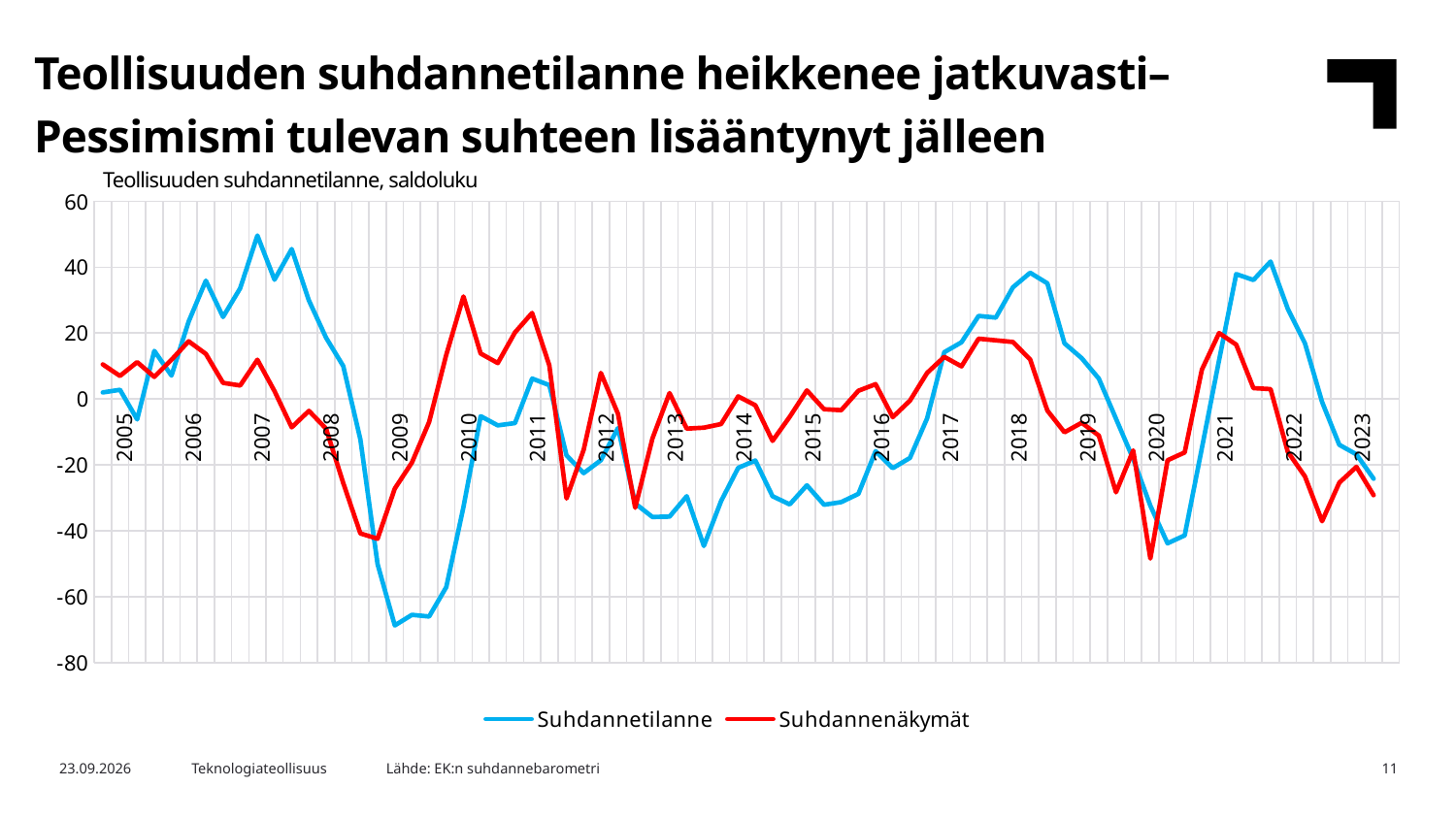
Is the peak of the Suhdannenäkymät line around 2010 greater or less than 20? greater Is the lowest value of the Suhdannenäkymät line (around 2020) greater or less than -40? less Is the lowest value of the Suhdannetilanne line (around 2009) greater or less than -60? less What are the two series named in the legend? Suhdannetilanne and Suhdannenäkymät Which series reaches the highest value anywhere on the chart? Suhdannetilanne What is the title printed above the chart? Teollisuuden suhdannetilanne, saldoluku How many series does the legend list? 2 What kind of chart is shown on the slide? line chart Which series reaches the lowest value anywhere on the chart? Suhdannetilanne Does the Suhdannetilanne line rise or fall from its 2021 peak to 2023? fall Around 2009, which series has the lower value, Suhdannetilanne or Suhdannenäkymät? Suhdannetilanne